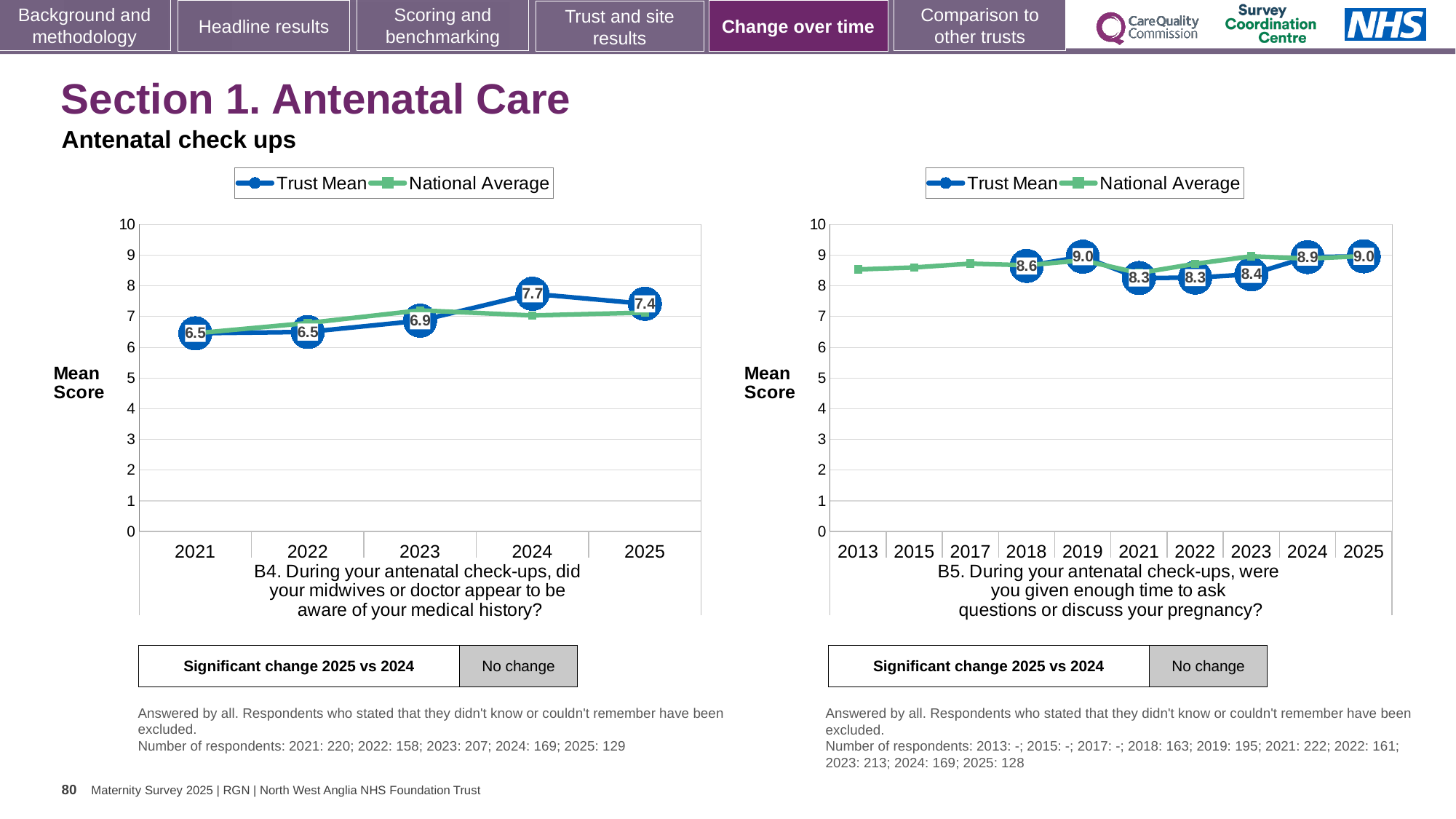
In the left chart (B4), is the National Average for 2021 greater or less than 7? less In the left chart (B4), what is the Trust Mean for 2025? 7.4 In the left chart (B4), what is the difference between the Trust Mean in 2024 and in 2021? 1.2 What kind of chart is the left chart (B4)? Line chart In the left chart (B4), how many years are shown on the x axis? 5 In the right chart (B5), is the Trust Mean for 2018 larger or smaller than the Trust Mean for 2024? smaller How many series does the legend of the right chart (B5) list? 2 In the right chart (B5), how many years are shown on the x axis? 10 In the right chart (B5), what is the Trust Mean for 2023? 8.4 In the left chart (B4), which year has the highest Trust Mean? 2024 In the left chart (B4), what is the Trust Mean for 2024? 7.7 In the right chart (B5), what is the Trust Mean for 2019? 9.0